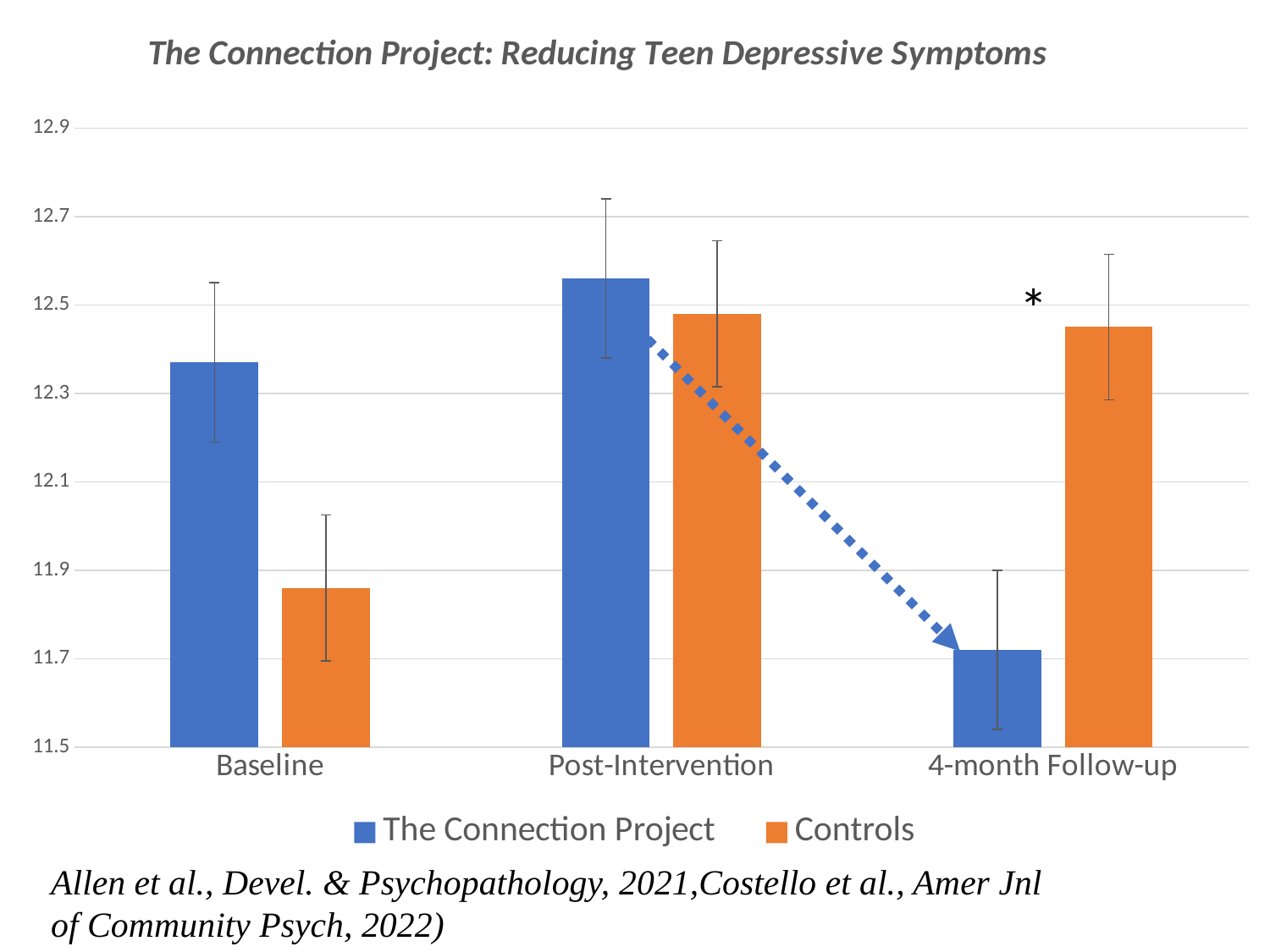
Which colour represents the Controls series? orange How many series does the legend list? 2 Is the value for The Connection Project at 4-month Follow-up greater or less than 11.9? less For The Connection Project series, which category has the lowest value? 4-month Follow-up What is the title of the chart? The Connection Project: Reducing Teen Depressive Symptoms At Baseline, which is larger: The Connection Project or Controls? The Connection Project What kind of chart is shown on the slide? bar chart For The Connection Project series, which category has the highest value? Post-Intervention At 4-month Follow-up, which is larger: The Connection Project or Controls? Controls For the Controls series, which category has the lowest value? Baseline How many categories are shown on the x axis? 3 Is the value for Controls at 4-month Follow-up greater or less than 12.3? greater